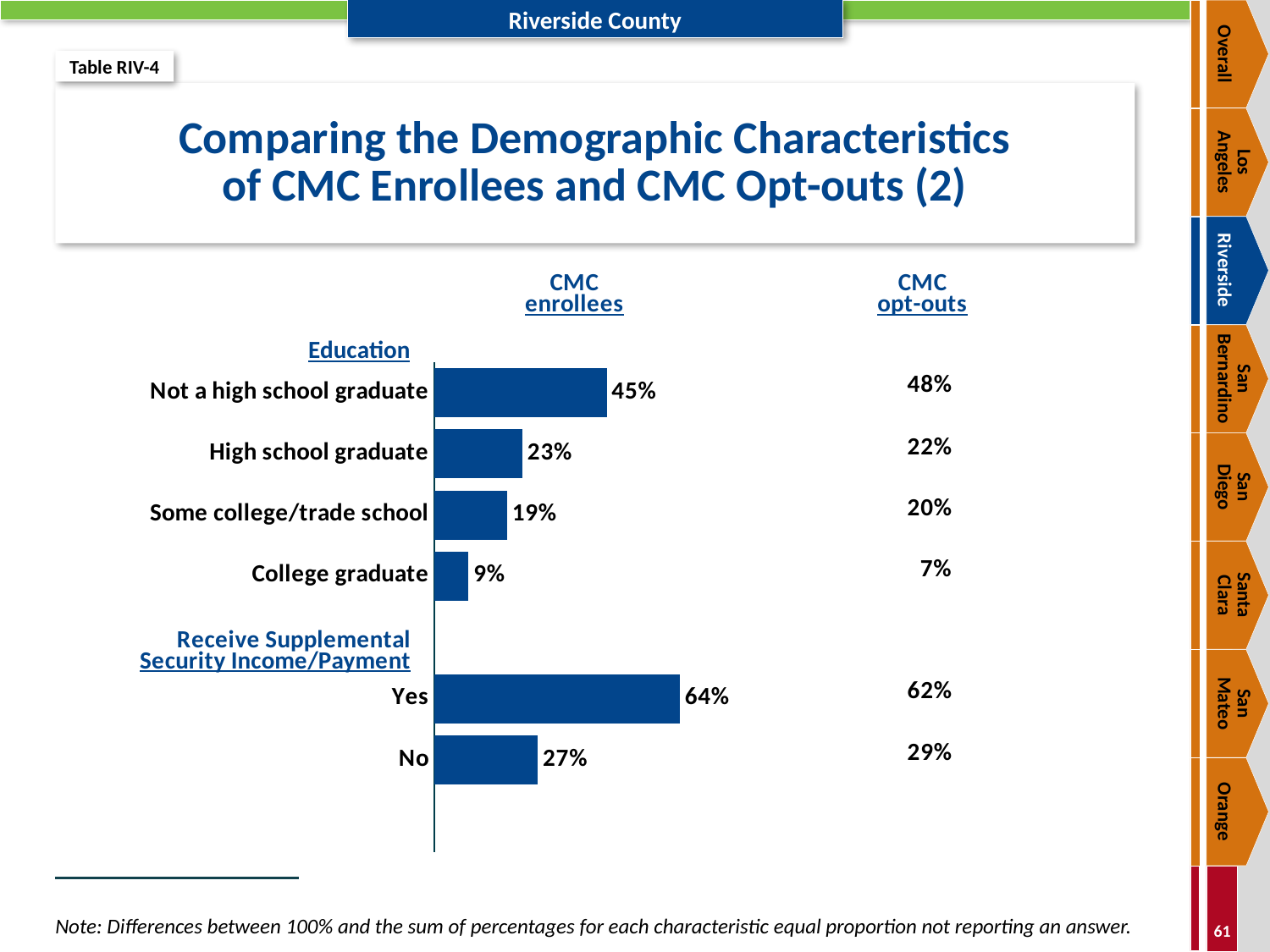
Which education category has the lowest percentage among CMC enrollees? College graduate How many education categories are shown in the chart? 4 What percentage of CMC opt-outs answered No to receiving Supplemental Security Income/Payment? 29% What is the table label shown at the top left of the slide? Table RIV-4 What is the difference between the Yes and No percentages for CMC enrollees receiving Supplemental Security Income/Payment? 37% What percentage of CMC enrollees are not a high school graduate? 45% What percentage of CMC opt-outs are college graduates? 7% Which is larger for Some college/trade school: the CMC enrollees value or the CMC opt-outs value? CMC opt-outs Which education category has the highest percentage among CMC enrollees? Not a high school graduate What type of chart is used to show the CMC enrollees values? Bar chart What is the difference between the CMC enrollees and CMC opt-outs percentages for Not a high school graduate? 3% What percentage of CMC enrollees receive Supplemental Security Income/Payment (Yes)? 64%